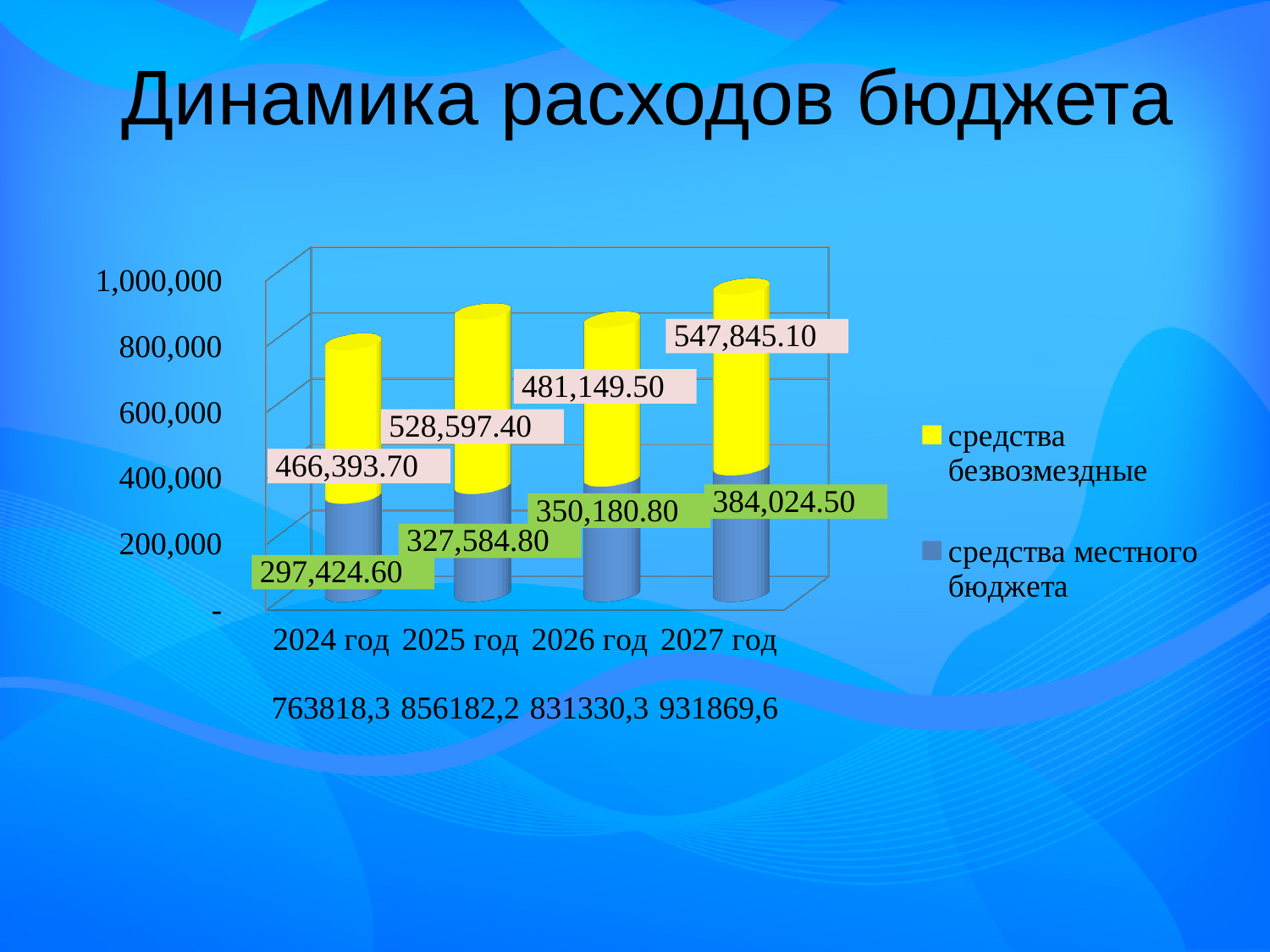
In which year is средства местного бюджета highest? 2027 год What is the value of средства безвозмездные for 2027 год? 547,845.10 What is the total of the stacked bar for 2025 год? 856182,2 Does средства местного бюджета rise or fall from 2024 год to 2027 год? rise What is the value of средства местного бюджета for 2024 год? 297,424.60 How many years are shown on the x axis? 4 In which year is средства безвозмездные lowest? 2024 год How many series does the legend list? 2 Which is larger: средства безвозмездные in 2025 год or in 2026 год? 2025 год What is the difference between средства безвозмездные in 2027 год and in 2024 год? 81,451.40 What kind of chart is shown on the slide? stacked bar chart What is the value of средства безвозмездные for 2026 год? 481,149.50